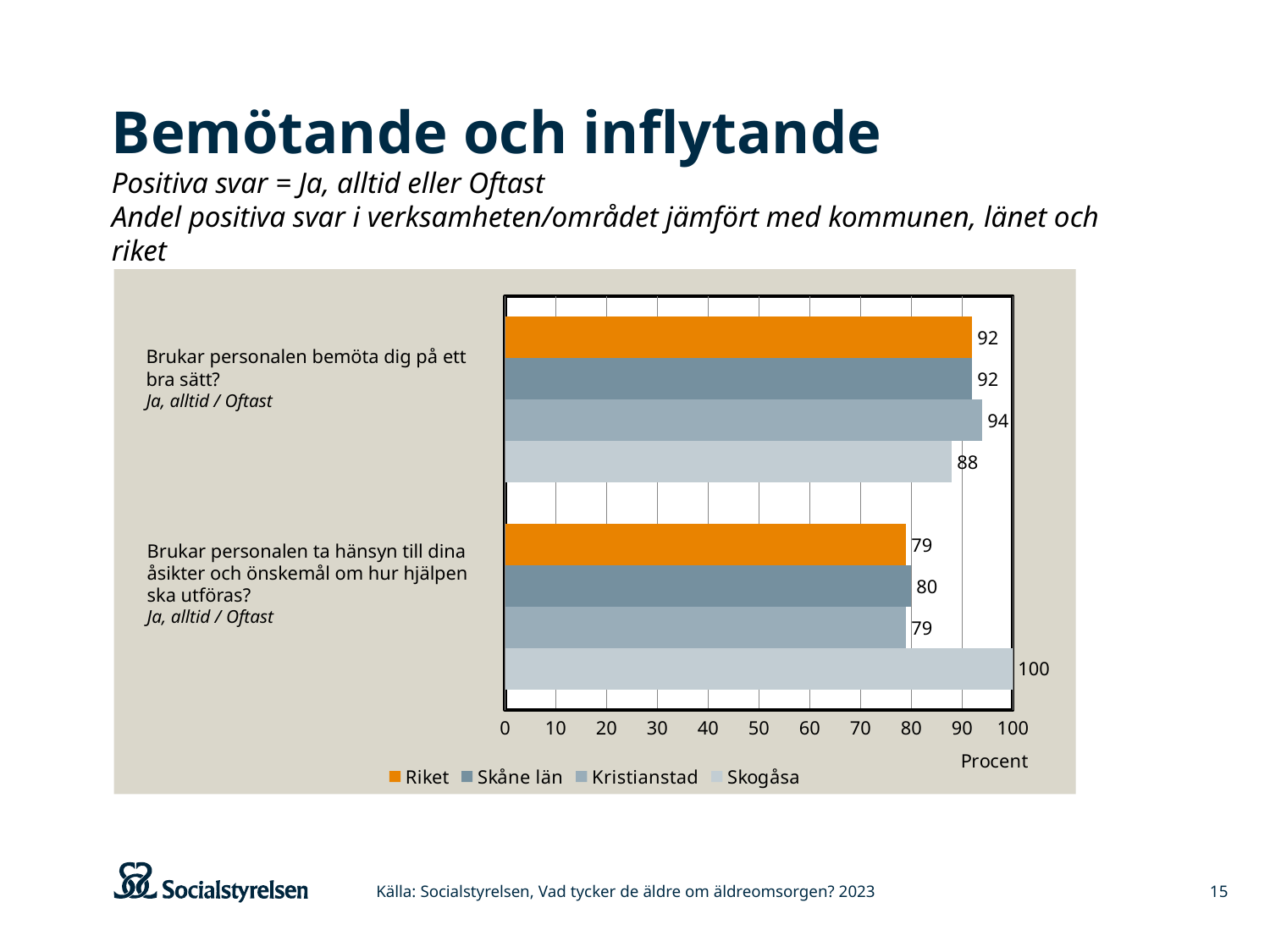
What is the value for Skåne län for the question "Brukar personalen ta hänsyn till dina åsikter och önskemål om hur hjälpen ska utföras?"? 80 How many series does the legend list? 4 Which series has the lowest value for the question "Brukar personalen bemöta dig på ett bra sätt?"? Skogåsa What is the value for Skogåsa for the question "Brukar personalen bemöta dig på ett bra sätt?"? 88 What is the value for Skogåsa for the question "Brukar personalen ta hänsyn till dina åsikter och önskemål om hur hjälpen ska utföras?"? 100 What is the difference between the Skogåsa value and the Riket value for the question "Brukar personalen ta hänsyn till dina åsikter och önskemål om hur hjälpen ska utföras?"? 21 What unit is labelled on the horizontal axis of the chart? Procent What is the difference between the Kristianstad value and the Skogåsa value for the question "Brukar personalen bemöta dig på ett bra sätt?"? 6 What is the value for Kristianstad for the question "Brukar personalen bemöta dig på ett bra sätt?"? 94 For the question "Brukar personalen bemöta dig på ett bra sätt?", is the value for Kristianstad or for Skogåsa larger? Kristianstad Which series has the highest value for the question "Brukar personalen ta hänsyn till dina åsikter och önskemål om hur hjälpen ska utföras?"? Skogåsa What kind of chart is shown on the slide? Bar chart